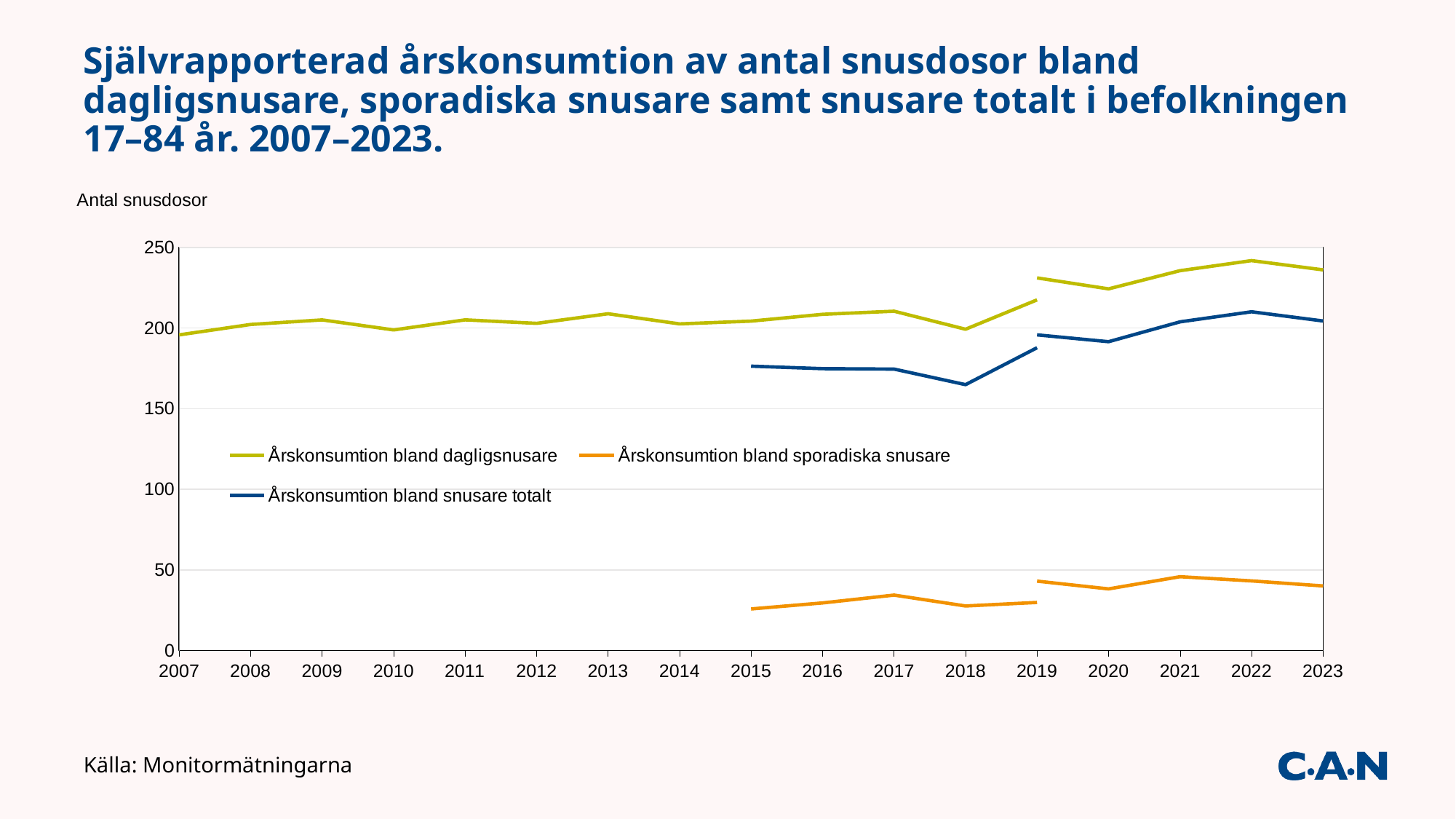
For Årskonsumtion bland snusare totalt, which year has the higher value: 2018 or 2019? 2019 Is the value for Årskonsumtion bland dagligsnusare in 2007 greater or less than 150? greater How many years are shown on the x axis? 17 In 2020, which series has the higher value: Årskonsumtion bland dagligsnusare or Årskonsumtion bland sporadiska snusare? Årskonsumtion bland dagligsnusare What is the label on the y axis of the chart? Antal snusdosor Is the value for Årskonsumtion bland sporadiska snusare in 2015 greater or less than 50? less Is the value for Årskonsumtion bland dagligsnusare in 2022 greater or less than 200? greater What kind of chart is shown on the slide? line chart Does Årskonsumtion bland snusare totalt rise or fall from 2018 to 2022? rise How many series does the legend list? 3 In which year is Årskonsumtion bland snusare totalt at its lowest? 2018